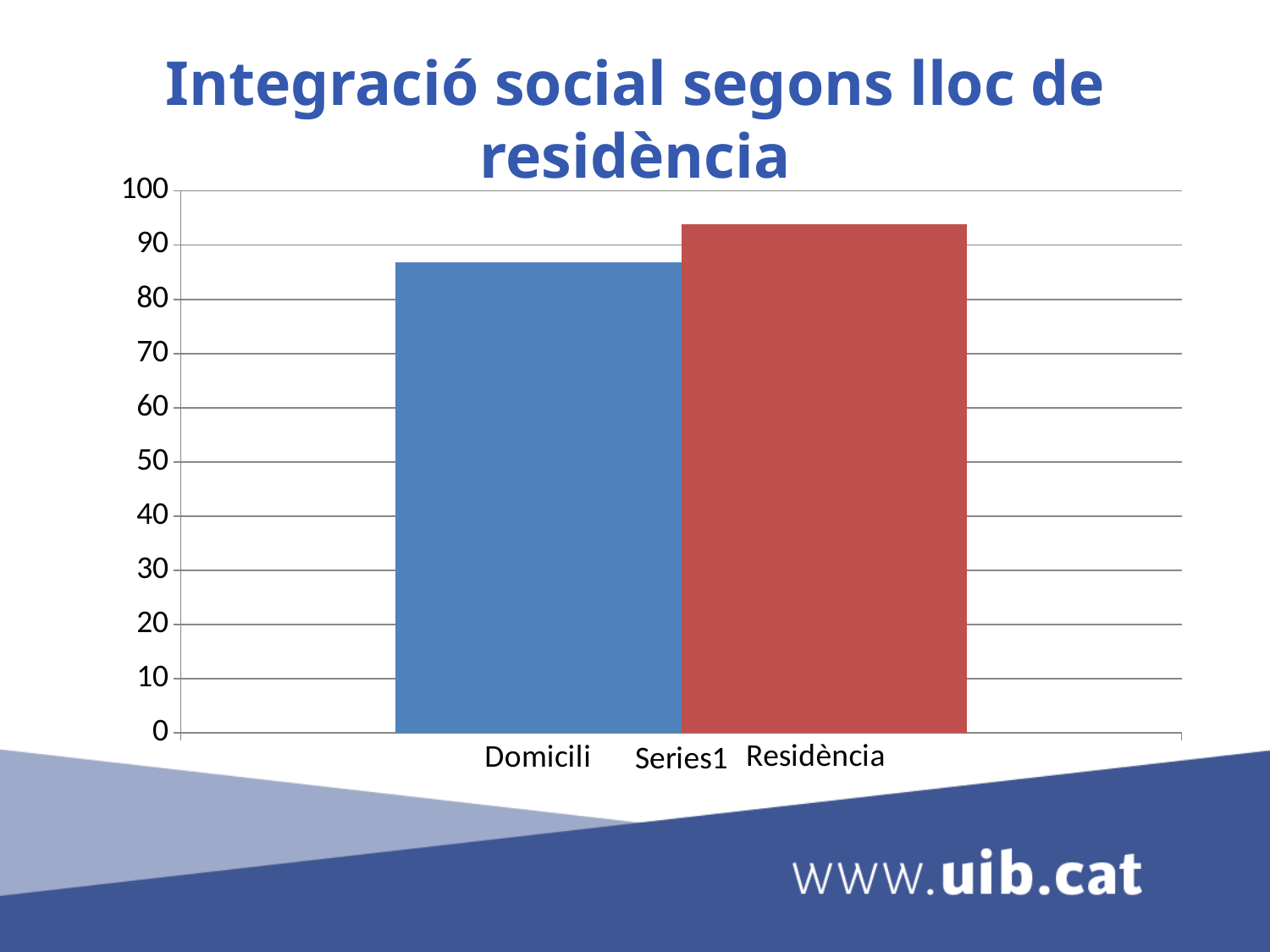
What is the title of the chart? Integració social segons lloc de residència What is the maximum value shown on the vertical axis? 100 What colour is the bar for Domicili? blue Which category has the lowest value? Domicili Is the value for Residència greater or less than 90? greater Is the value for Domicili greater or less than 80? greater Which category has the highest value? Residència How many bars are plotted in the chart? 2 What kind of chart is shown on the slide? bar chart Is the value for Residència greater or less than 100? less Which is larger, the value for Domicili or the value for Residència? Residència